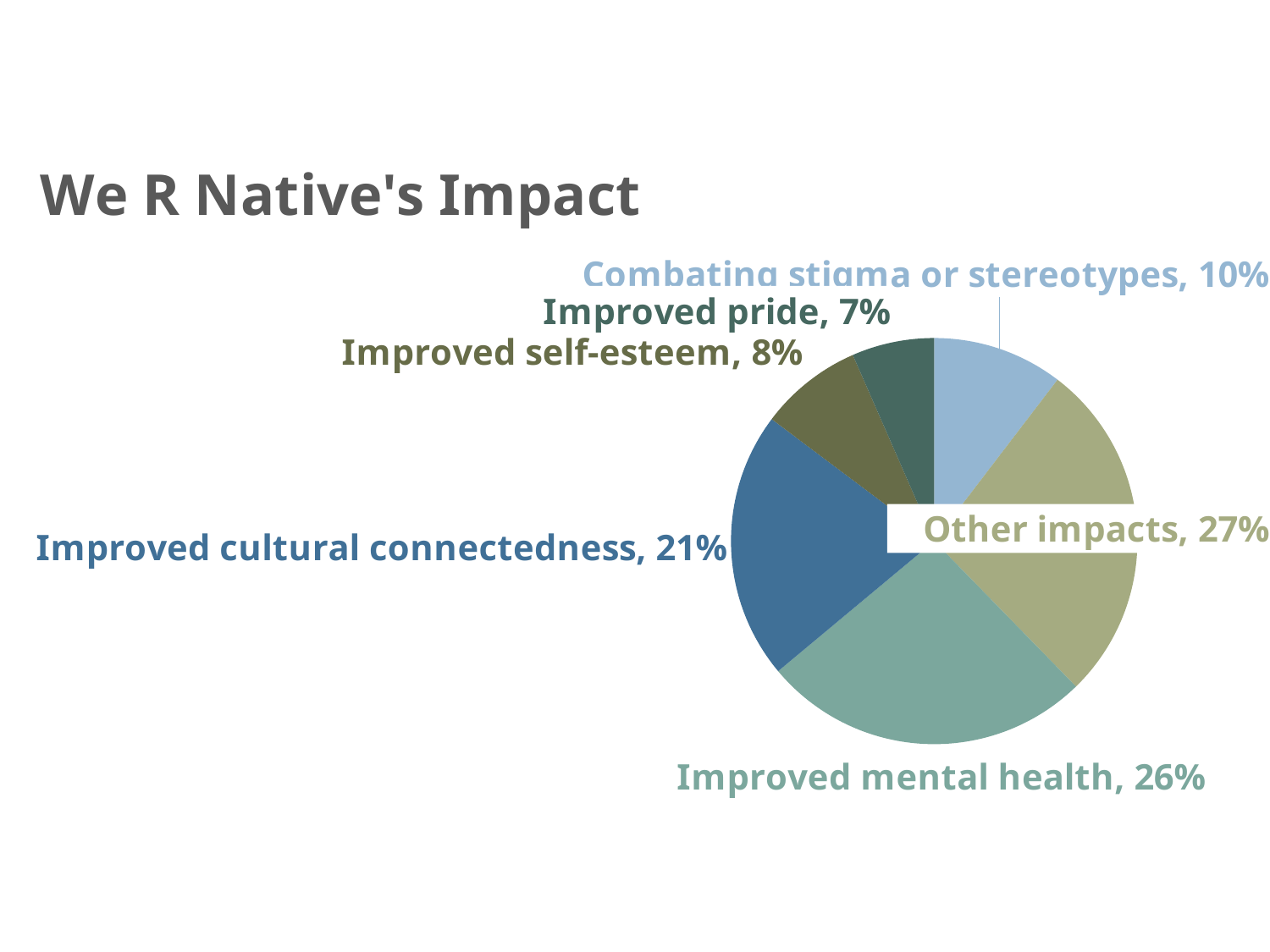
How many slices does the pie chart have? 6 What is the title of the chart? We R Native's Impact What kind of chart is shown on the slide? Pie chart Which slice of the pie is the smallest? Improved pride What percentage is shown for Improved cultural connectedness? 21% Which is larger, Improved self-esteem or Improved pride? Improved self-esteem What is the difference in percentage points between Improved mental health and Improved cultural connectedness? 5 What percentage is shown for Improved self-esteem? 8% What share of the pie is labelled Improved mental health? 26% What percentage is shown for Combating stigma or stereotypes? 10% Which slice of the pie is the largest? Other impacts What is the combined percentage of Improved pride and Improved self-esteem? 15%